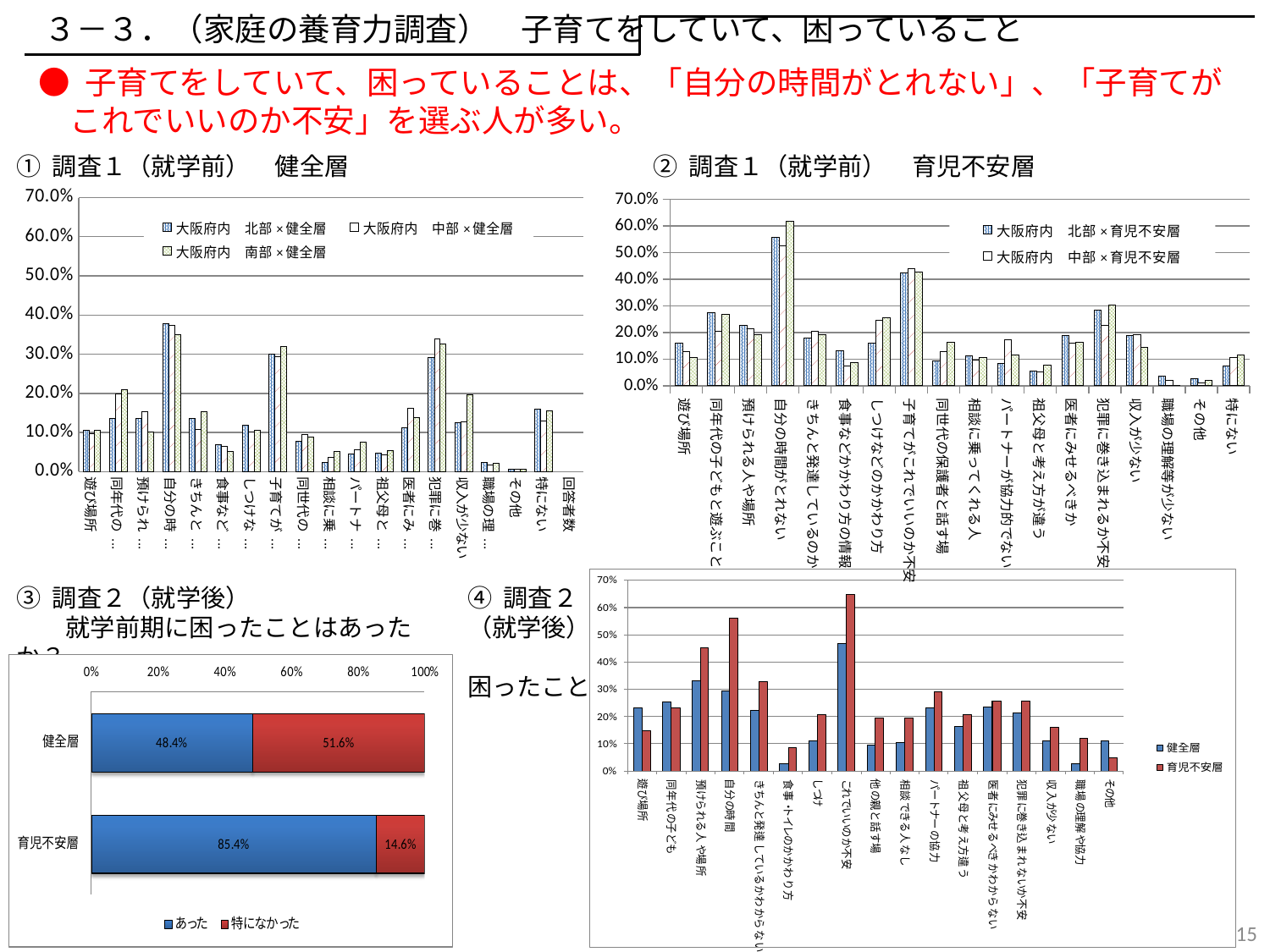
In chart ③ (調査２ 就学前期に困ったことはあったか), what is the value of あった for 健全層? 48.4% In chart ③ (調査２ 就学前期に困ったことはあったか), what is the total of the stacked bar for 健全層? 100.0% In chart ③ (調査２ 就学前期に困ったことはあったか), what is the value of 特になかった for 育児不安層? 14.6% What kind of chart is chart ③ (調査２ 就学前期に困ったことはあったか)? Stacked bar chart In chart ③ (調査２ 就学前期に困ったことはあったか), which group has the larger あった value, 健全層 or 育児不安層? 育児不安層 In chart ③ (調査２ 就学前期に困ったことはあったか), what is the difference between the あった values for 育児不安層 and 健全層? 37.0% In chart ④ (調査２ 就学後 困ったこと), which category has the highest value for 育児不安層? これでいいのか不安 In chart ② (調査１ 就学前 育児不安層), is the value of 自分の時間がとれない for 大阪府内 中部×育児不安層 greater or less than 50.0%? greater In chart ① (調査１ 就学前 健全層), how many series does the legend list? 3 In chart ② (調査１ 就学前 育児不安層), which category has the highest value for 大阪府内 北部×育児不安層? 自分の時間がとれない In chart ③ (調査２ 就学前期に困ったことはあったか), how many series does the legend list? 2 In chart ④ (調査２ 就学後 困ったこと), how many series does the legend list? 2